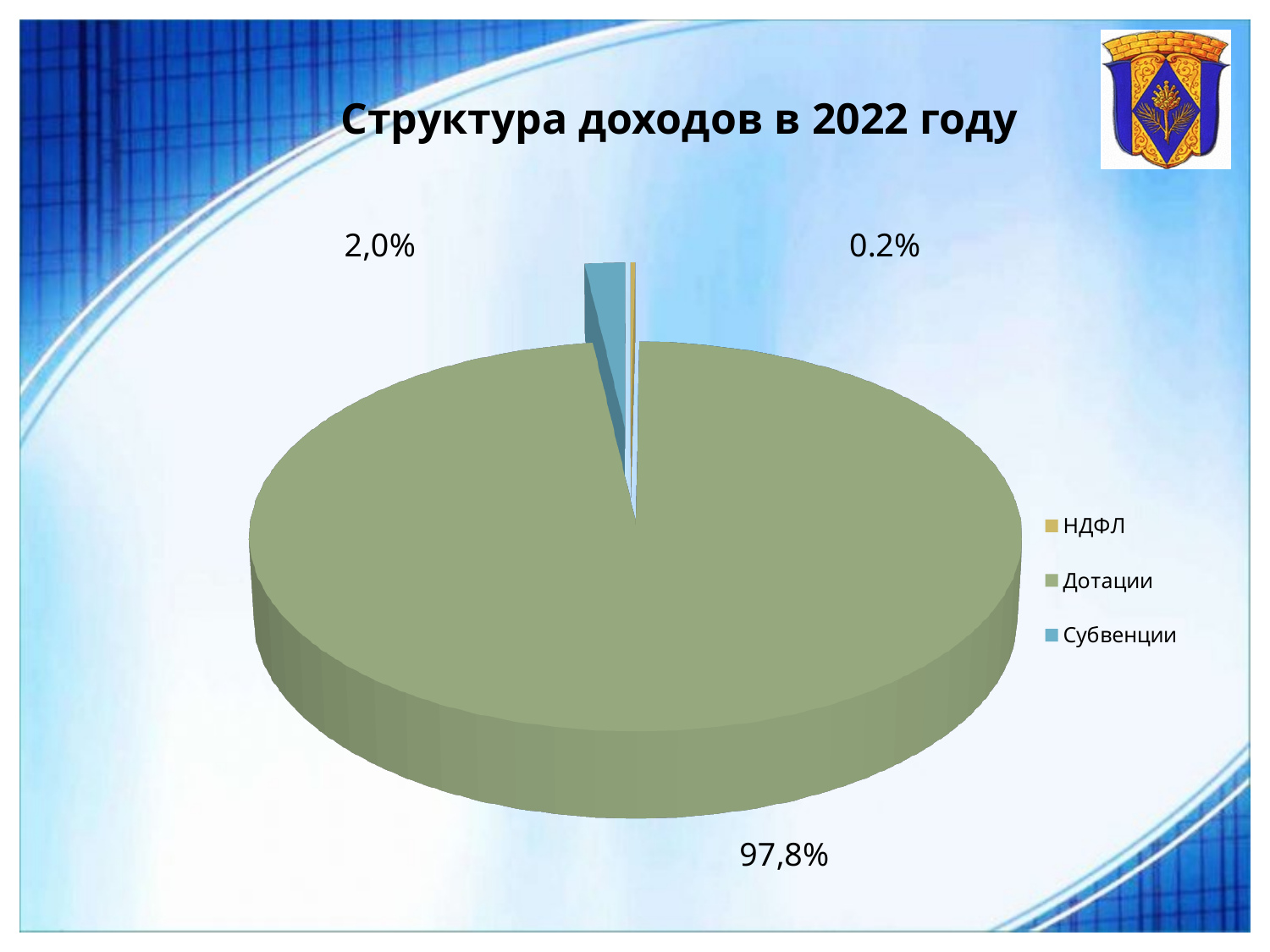
What is the value shown for НДФЛ? 0.2% How many categories does the pie chart show? 3 Which is larger, the slice for Субвенции or the slice for НДФЛ? Субвенции Which category has the largest slice of the pie? Дотации Which category has the smallest slice of the pie? НДФЛ What is the difference between the values for Дотации and Субвенции? 95,8% What is the value shown for Субвенции? 2,0% What kind of chart is shown on the slide? Pie chart Which category is shown in blue in the legend? Субвенции What share of the pie does Дотации hold? 97,8% What is the title of the chart? Структура доходов в 2022 году